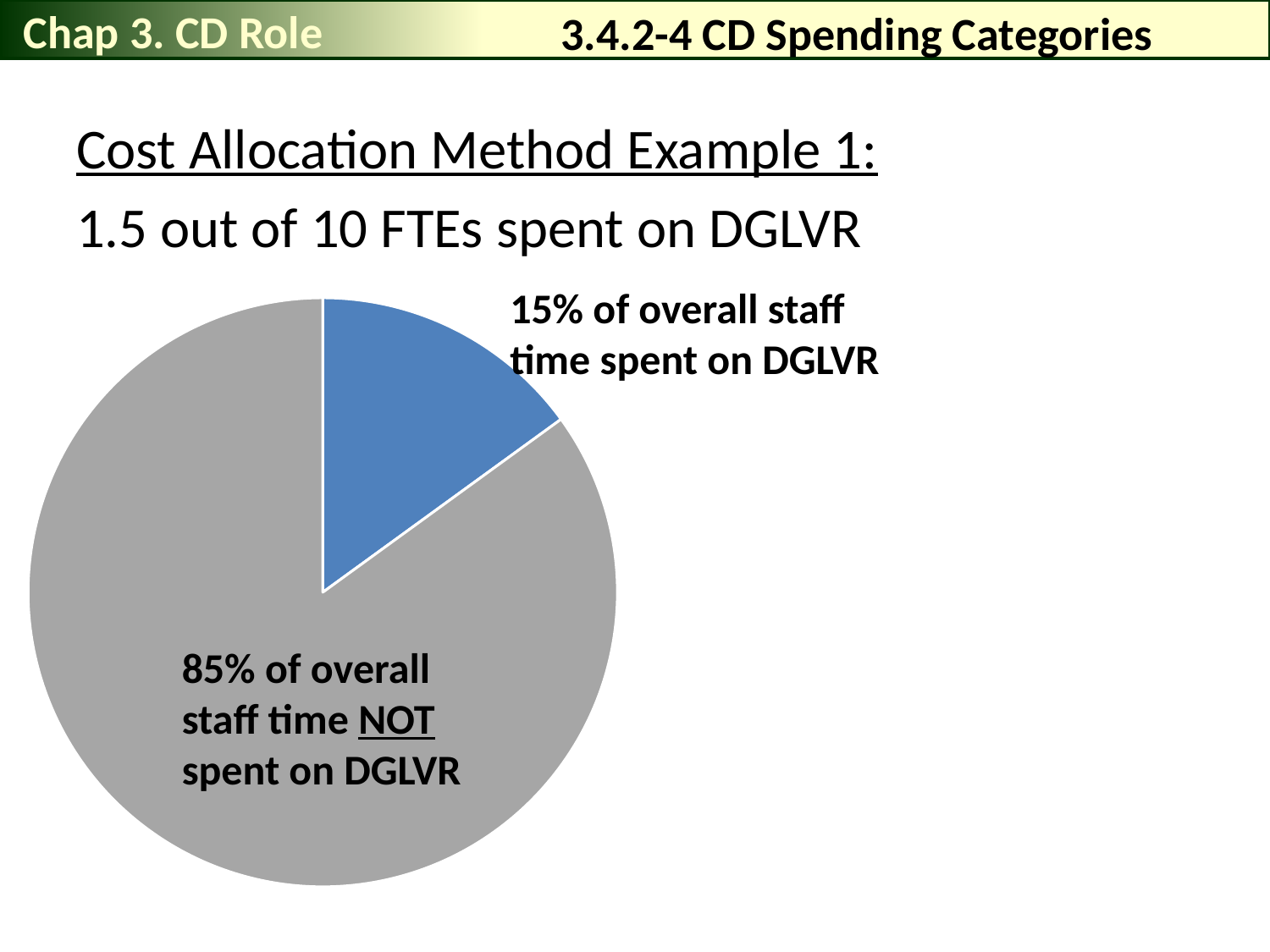
Which slice of the pie chart is the largest? 85% of overall staff time NOT spent on DGLVR Which slice of the pie chart is larger: staff time spent on DGLVR or staff time NOT spent on DGLVR? staff time NOT spent on DGLVR What kind of chart is shown on the slide? pie chart What colour is the slice representing staff time spent on DGLVR? blue What is the difference in percentage points between the share of staff time NOT spent on DGLVR and the share spent on DGLVR? 70 percentage points What share of overall staff time is NOT spent on DGLVR according to the pie chart? 85% How many slices does the pie chart have? 2 What colour is the slice representing staff time NOT spent on DGLVR? grey What share of overall staff time is spent on DGLVR according to the pie chart? 15% How many FTEs out of 10 are spent on DGLVR according to the slide? 1.5 Which slice of the pie chart is the smallest? 15% of overall staff time spent on DGLVR Is the share of staff time spent on DGLVR greater or less than 50%? less